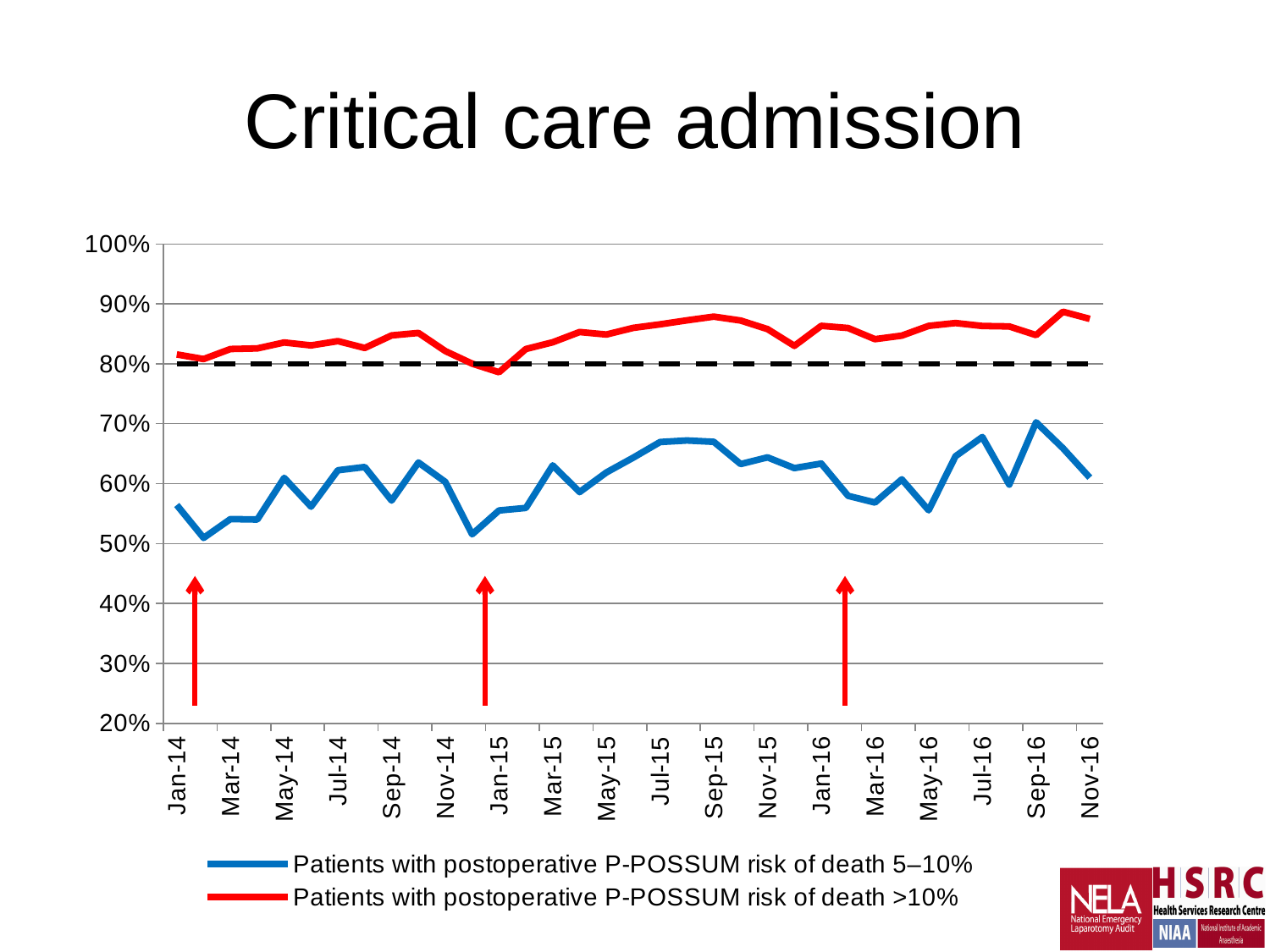
Which series is drawn in red? Patients with postoperative P-POSSUM risk of death >10% What is the title of the chart? Critical care admission In which month does the series for patients with P-POSSUM risk of death 5–10% reach its highest value? Sep-16 How many month labels are shown on the x axis? 18 Is the value for patients with P-POSSUM risk of death 5–10% at Jan-14 greater or less than 50%? greater At Jul-15, which series has the higher value: risk of death 5–10% or risk of death >10%? Patients with postoperative P-POSSUM risk of death >10% How many series does the legend list? 2 Is the value for patients with P-POSSUM risk of death 5–10% at Jan-15 greater or less than 60%? less Is the value for patients with P-POSSUM risk of death >10% at Jan-14 greater or less than 80%? greater What kind of chart is shown on the slide? Line chart